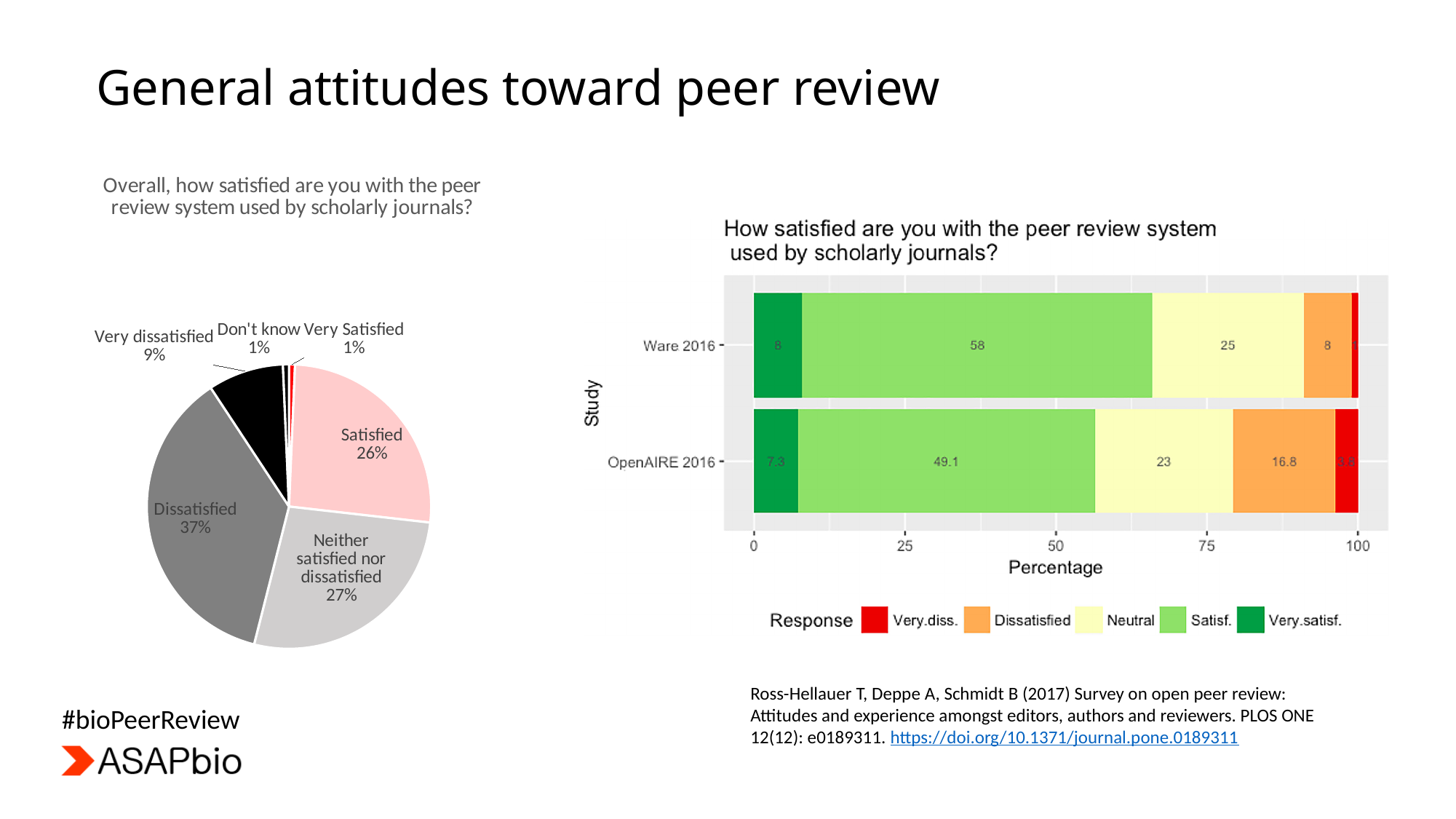
In the stacked bar chart on the right, what is the "Satisf." value for OpenAIRE 2016? 49.1 In the stacked bar chart on the right, what is the "Neutral" value for Ware 2016? 25 In the pie chart on the left, what is the difference in percentage points between "Dissatisfied" and "Satisfied"? 11 In the pie chart on the left, which is larger, the "Very dissatisfied" slice or the "Very Satisfied" slice? Very dissatisfied In the pie chart on the left, how many slices does the pie have? 6 In the pie chart on the left, what share of respondents answered "Dissatisfied"? 37% In the pie chart on the left, what share of respondents answered "Neither satisfied nor dissatisfied"? 27% In the stacked bar chart on the right, which study has the larger "Satisf." value, Ware 2016 or OpenAIRE 2016? Ware 2016 What kind of chart is shown on the right side of the slide? Stacked bar chart In the stacked bar chart on the right, how many response categories does the legend list? 5 In the stacked bar chart on the right, what is the "Dissatisfied" value for OpenAIRE 2016? 16.8 In the pie chart on the left, which response has the largest slice? Dissatisfied